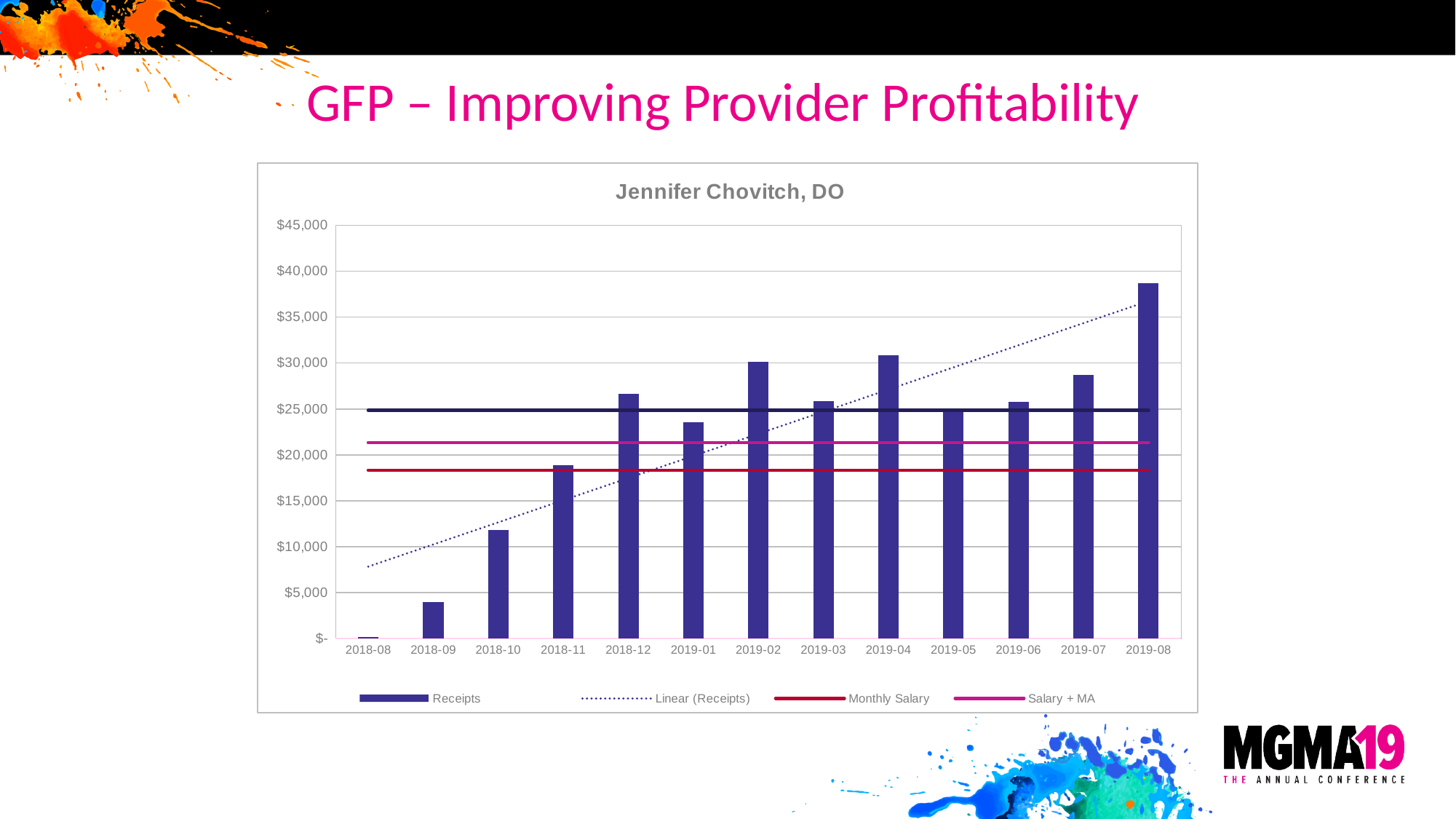
Which month has the highest Receipts bar? 2019-08 How many months are shown on the x axis of the chart? 13 Which month has the lowest Receipts bar? 2018-08 How many series does the chart legend list? 4 Do the Receipts values generally rise or fall from 2018-08 to 2019-08? rise Is the Receipts value for 2019-01 greater or less than $25,000? less Which legend entry is drawn as a dotted line? Linear (Receipts) What is the title of the chart? Jennifer Chovitch, DO Which month has the larger Receipts value, 2019-06 or 2019-07? 2019-07 What kind of chart is shown on the slide? combination bar and line chart Is the Receipts value for 2019-08 greater or less than $35,000? greater Is the Receipts value for 2018-09 greater or less than $5,000? less